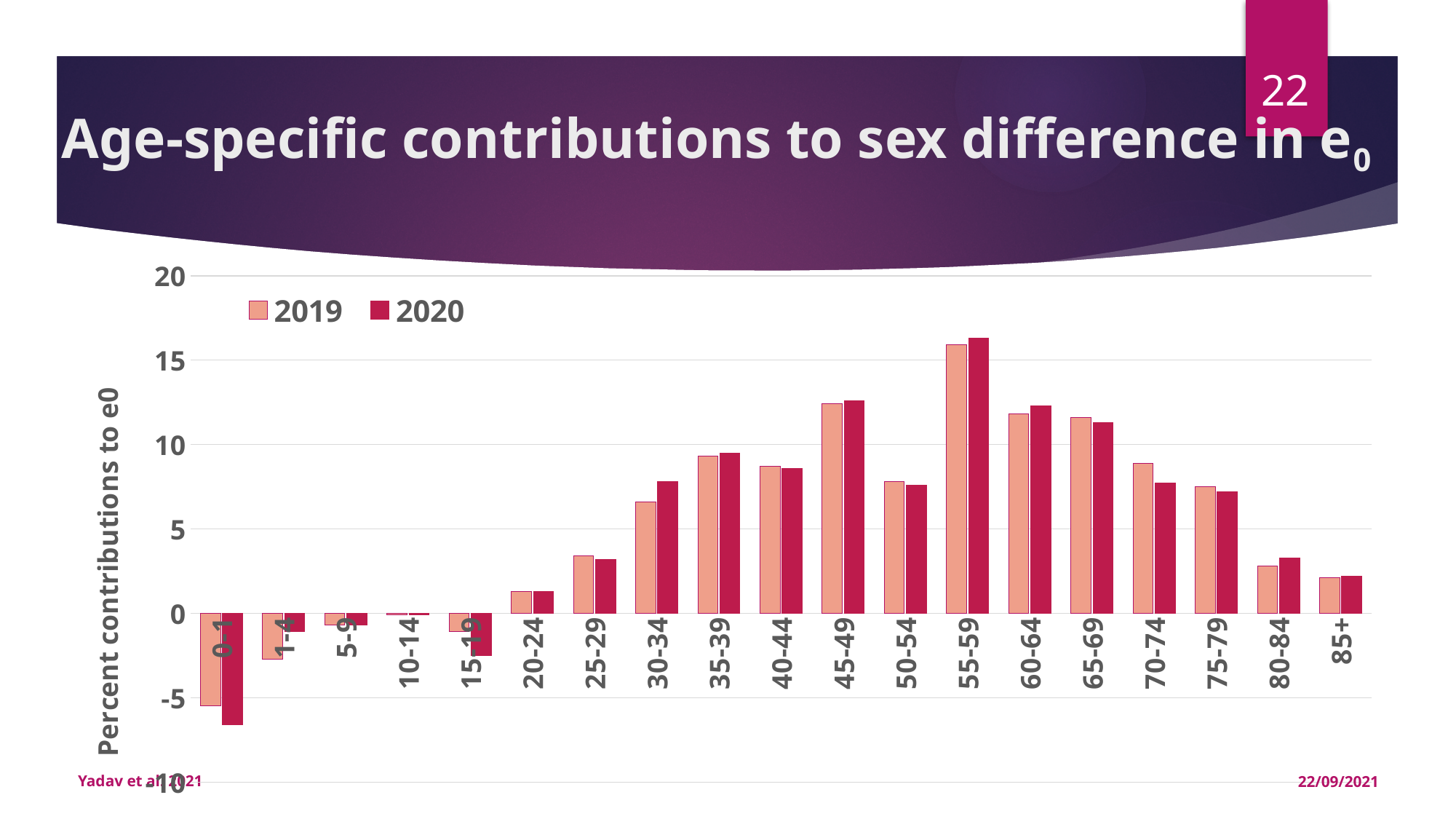
For the 30-34 age group, which series has the larger value, 2019 or 2020? 2020 For the 70-74 age group, which series has the larger value, 2019 or 2020? 2019 Is the 2020 value for the 0-1 age group greater or less than -5? less Is the 2019 value for the 45-49 age group greater or less than 10? greater What is the label of the y axis? Percent contributions to e0 Is the 2020 value for the 55-59 age group greater or less than 15? greater What kind of chart is shown on the slide? bar chart How many series does the legend list? 2 How many age-group categories are shown on the x axis? 19 Which age group has the highest value for the 2020 series? 55-59 Which age group has the lowest value for the 2019 series? 0-1